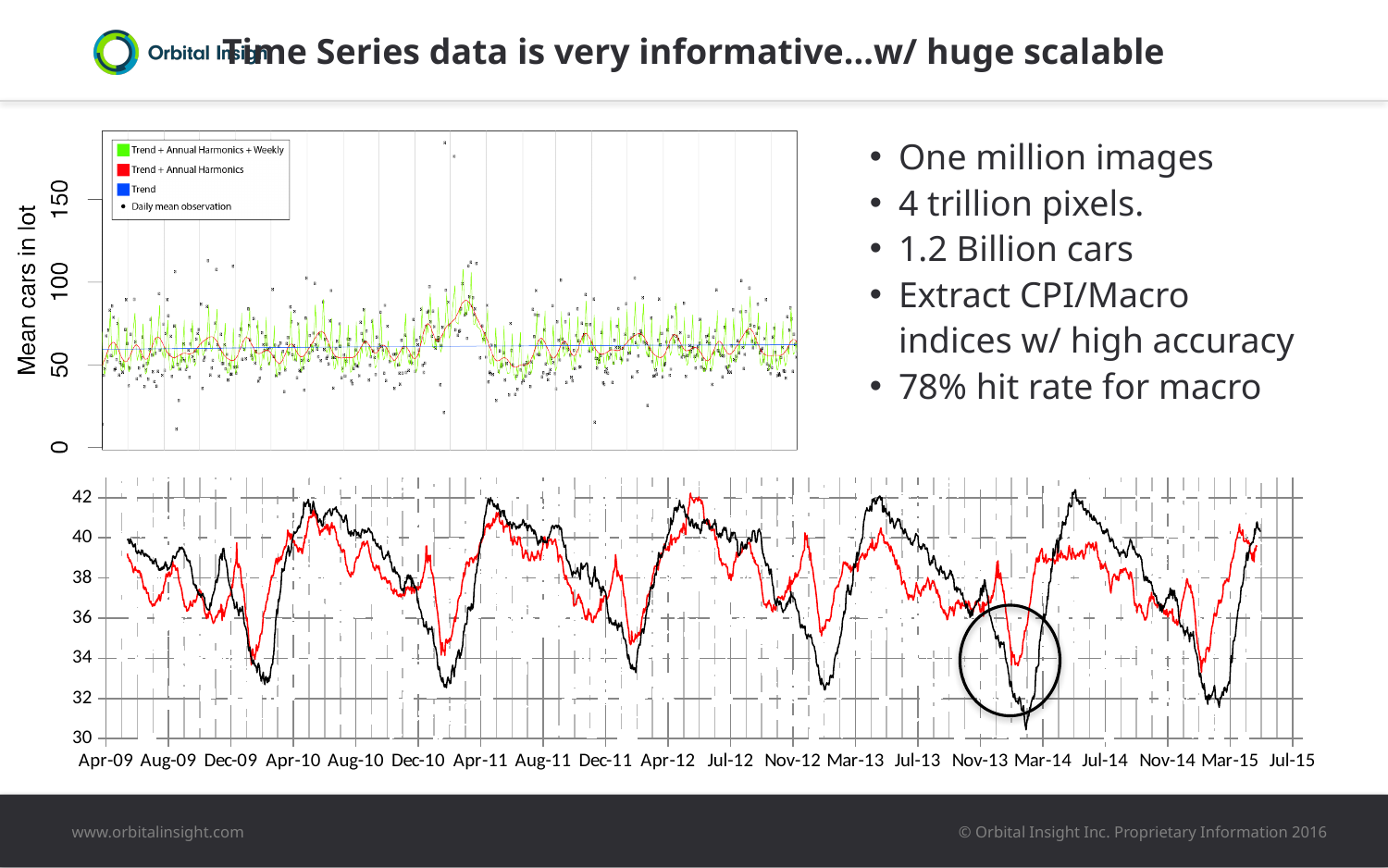
In the top chart, is the value of the blue Trend line greater or less than 100? less In the bottom chart, is the lowest value of the black line near Mar-14 greater or less than 32? less In the top chart, what colour is the 'Trend' series in the legend? Blue In the top chart, how many entries does the legend list? 4 In the bottom chart, how many lines are plotted? 2 In the bottom chart, at the dip near Mar-14, which line reaches the lower value, the black line or the red line? The black line What kind of chart is the bottom chart? Line chart In the bottom chart, how many labelled tick marks are on the x-axis? 20 In the top chart, is the value of the blue Trend line greater or less than 50? greater In the top chart, what is the label on the y-axis? Mean cars in lot